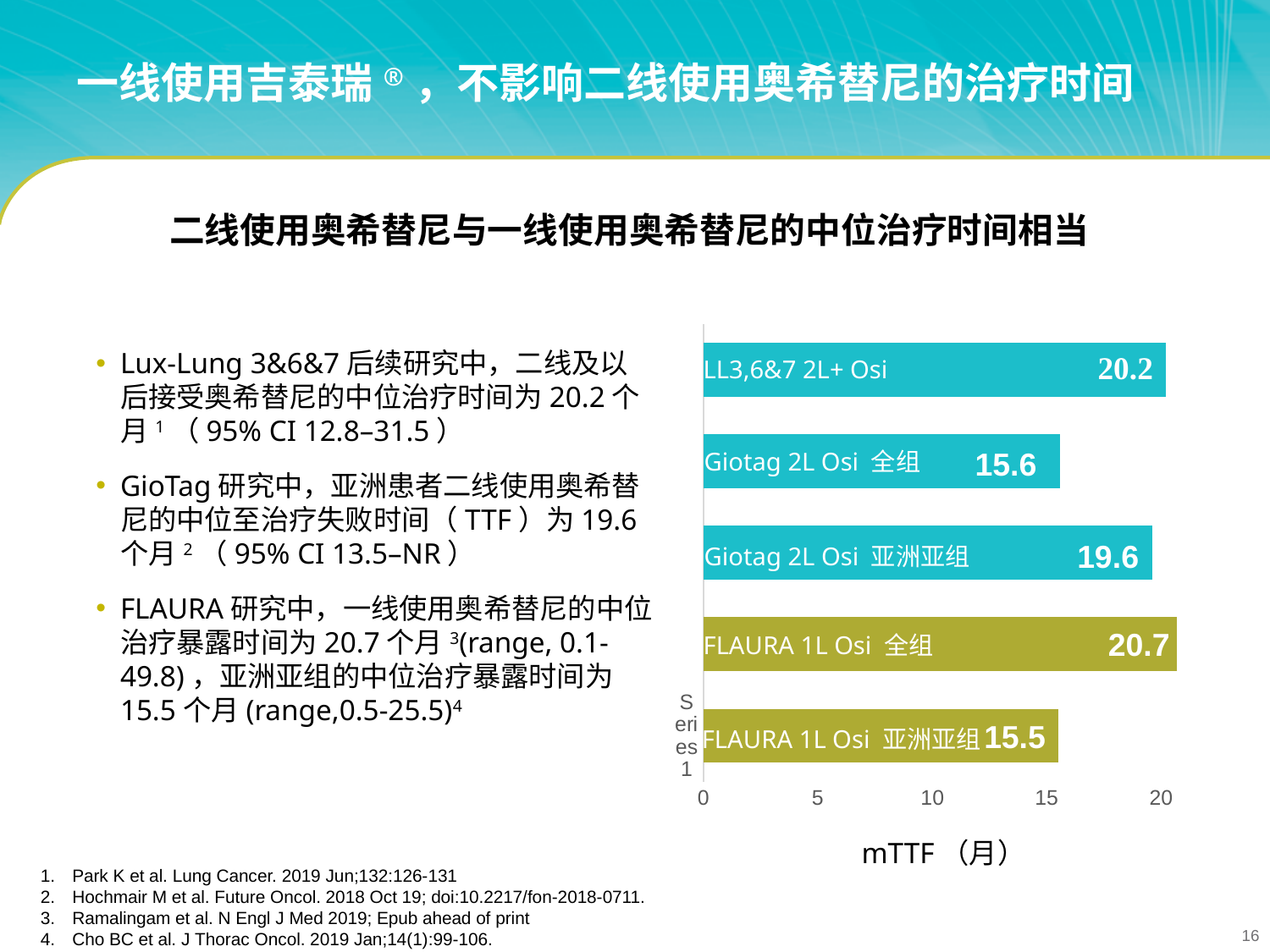
What type of chart is shown on the slide? bar chart What is the value for FLAURA 1L Osi 亚洲亚组? 15.5 What is the label of the x axis? mTTF（月） How many bars are plotted in the chart? 5 What is the difference between the values for FLAURA 1L Osi 全组 and LL3,6&7 2L+ Osi? 0.5 What is the value for LL3,6&7 2L+ Osi? 20.2 What is the value for Giotag 2L Osi 全组? 15.6 Which is larger, the value for Giotag 2L Osi 亚洲亚组 or Giotag 2L Osi 全组? Giotag 2L Osi 亚洲亚组 Which category has the highest value? FLAURA 1L Osi 全组 What is the value for FLAURA 1L Osi 全组? 20.7 Which category has the lowest value? FLAURA 1L Osi 亚洲亚组 What is the value for Giotag 2L Osi 亚洲亚组? 19.6